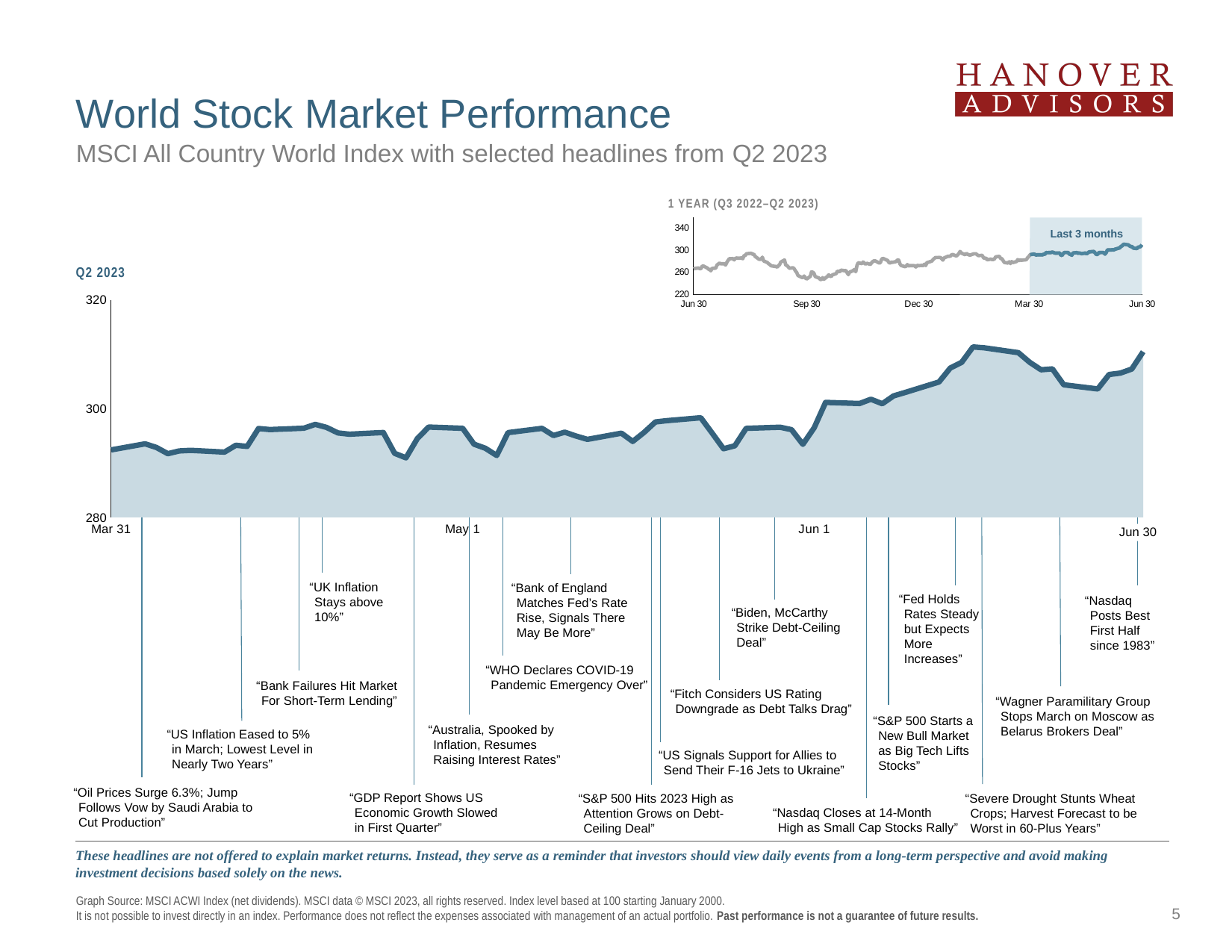
On the 1 YEAR (Q3 2022–Q2 2023) inset chart, is the value at Jun 30 (2023) greater or less than 300? greater On the Q2 2023 chart, is the value at Jun 30 greater or less than 300? greater On the 1 YEAR (Q3 2022–Q2 2023) inset chart, is the value at Dec 30 greater or less than 300? less In which month does the Q2 2023 chart reach its highest value? June On the Q2 2023 chart, which is larger, the value at Mar 31 or the value at Jun 30? Jun 30 On the Q2 2023 chart, which is larger, the value at May 1 or the value at Jun 30? Jun 30 What is the subtitle of the slide describing the chart? MSCI All Country World Index with selected headlines from Q2 2023 What label is shown on the shaded region of the 1 YEAR inset chart? Last 3 months On the Q2 2023 chart, does the index overall rise or fall from Mar 31 to Jun 30? rise How many date labels are shown on the x axis of the Q2 2023 chart? 4 What kind of chart is the large Q2 2023 chart on the slide? Line chart (area chart)